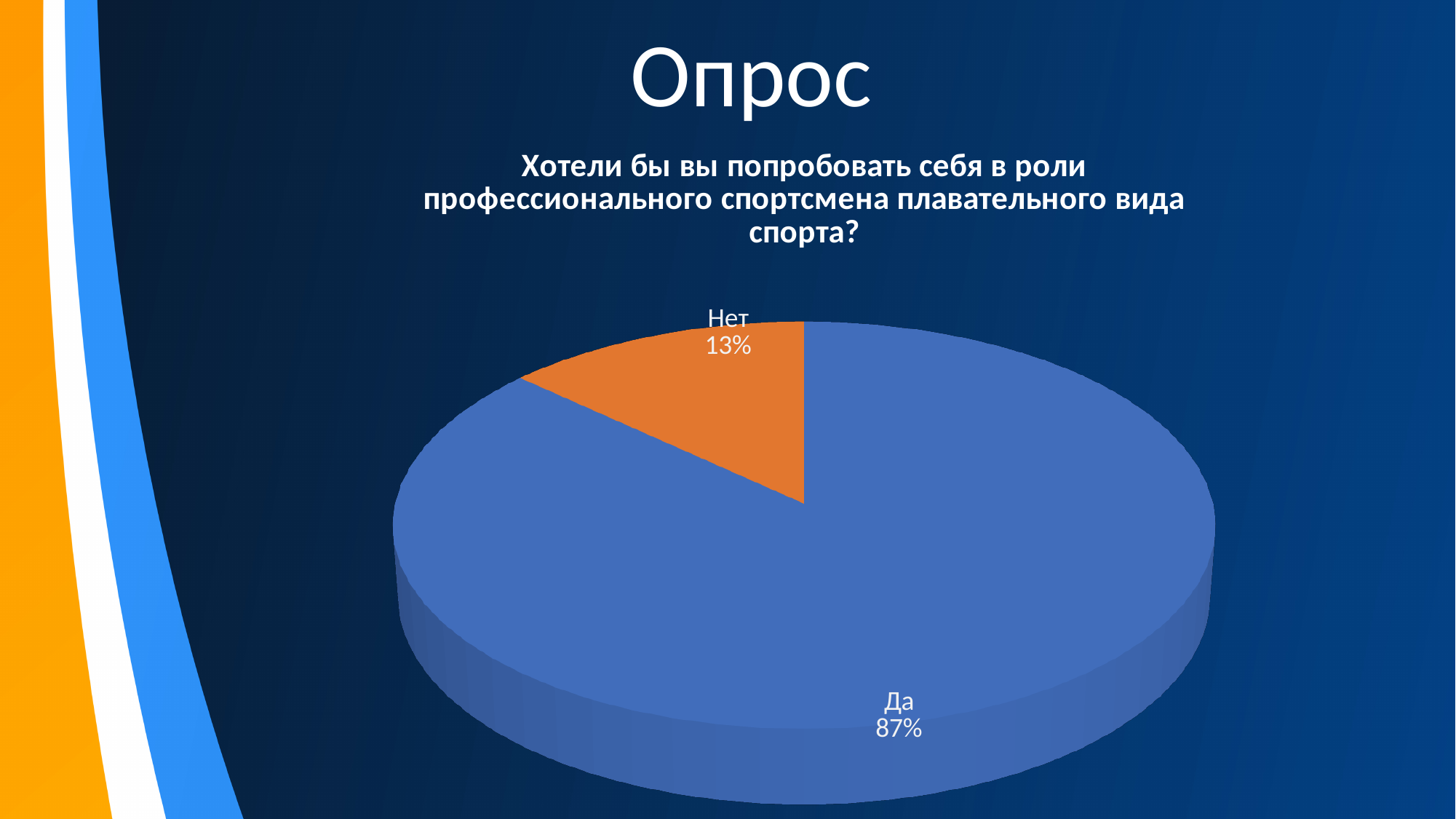
What share of the pie does the "Да" slice represent? 87% Which slice is larger, "Да" or "Нет"? Да What colour is the "Нет" slice? Orange What share of the pie does the "Нет" slice represent? 13% Is the share for "Да" greater or less than 50%? greater What kind of chart is shown on the slide? Pie chart Which slice is the smallest in the pie chart? Нет What is the title of the chart? Хотели бы вы попробовать себя в роли профессионального спортсмена плавательного вида спорта? How many slices does the pie chart have? 2 What is the difference in percentage points between the "Да" and "Нет" slices? 74 Which slice is the largest in the pie chart? Да